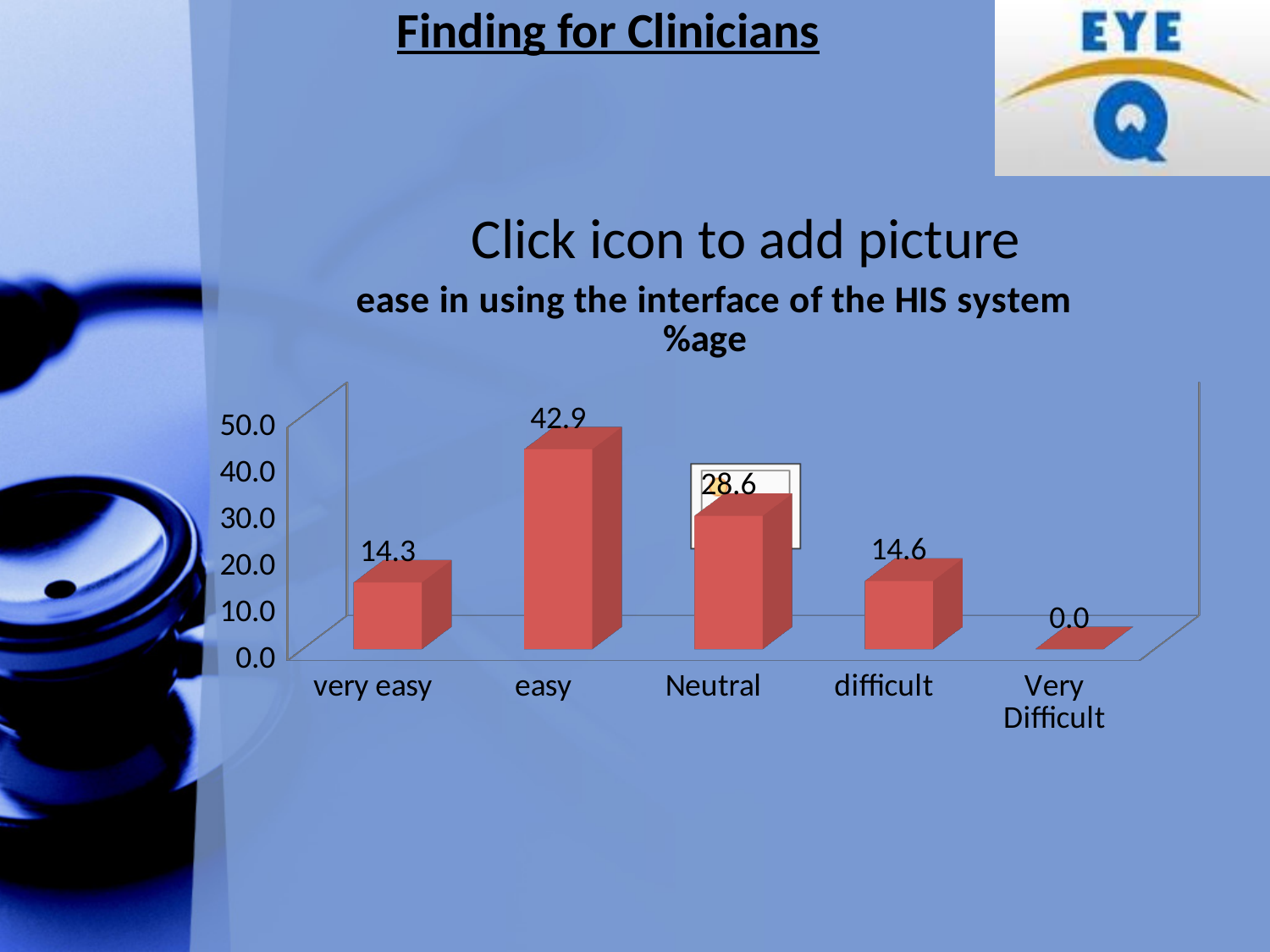
What is the title of the chart? ease in using the interface of the HIS system %age Is the value for "easy" greater or less than 40.0? greater What kind of chart is shown? bar chart How many categories are shown on the x axis? 5 What is the difference between the values for "easy" and "Neutral"? 14.3 Which category has the highest value? easy What is the value for "Very Difficult"? 0.0 Which category has the lowest value? Very Difficult What is the value for "easy"? 42.9 What is the value for "Neutral"? 28.6 What is the value for "very easy"? 14.3 Which is larger, the value for "Neutral" or the value for "difficult"? Neutral